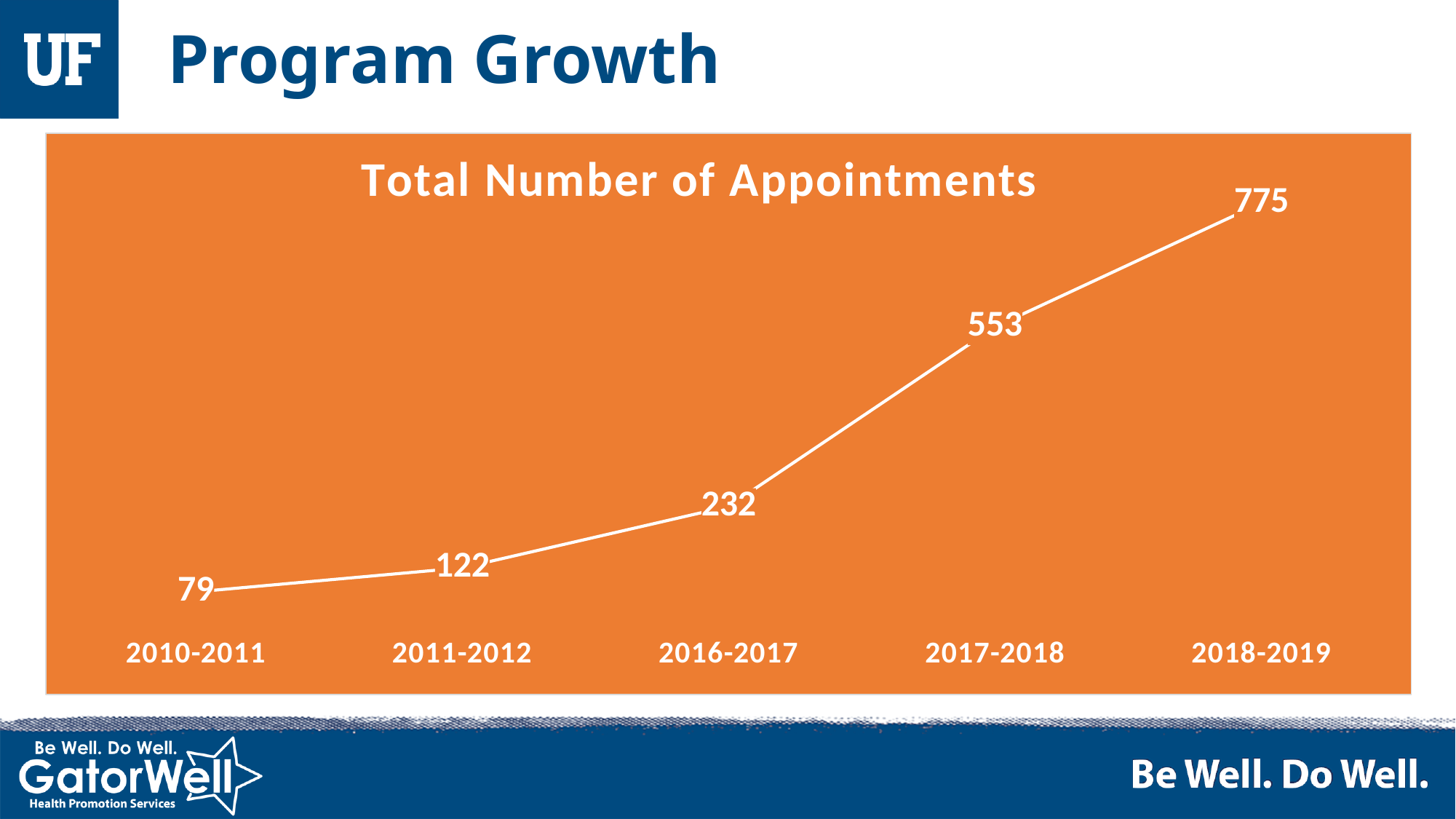
How many periods are plotted on the chart? 5 What is the total number of appointments for 2016-2017? 232 What kind of chart is shown on the slide? Line chart Which period has the highest total number of appointments? 2018-2019 Do the values rise or fall from 2010-2011 to 2018-2019? Rise What is the total number of appointments for 2018-2019? 775 What is the difference in appointments between 2017-2018 and 2016-2017? 321 Which period has the lowest total number of appointments? 2010-2011 What is the difference in appointments between 2018-2019 and 2010-2011? 696 What is the title of the chart? Total Number of Appointments What is the total number of appointments for 2010-2011? 79 Which period has more appointments, 2011-2012 or 2017-2018? 2017-2018